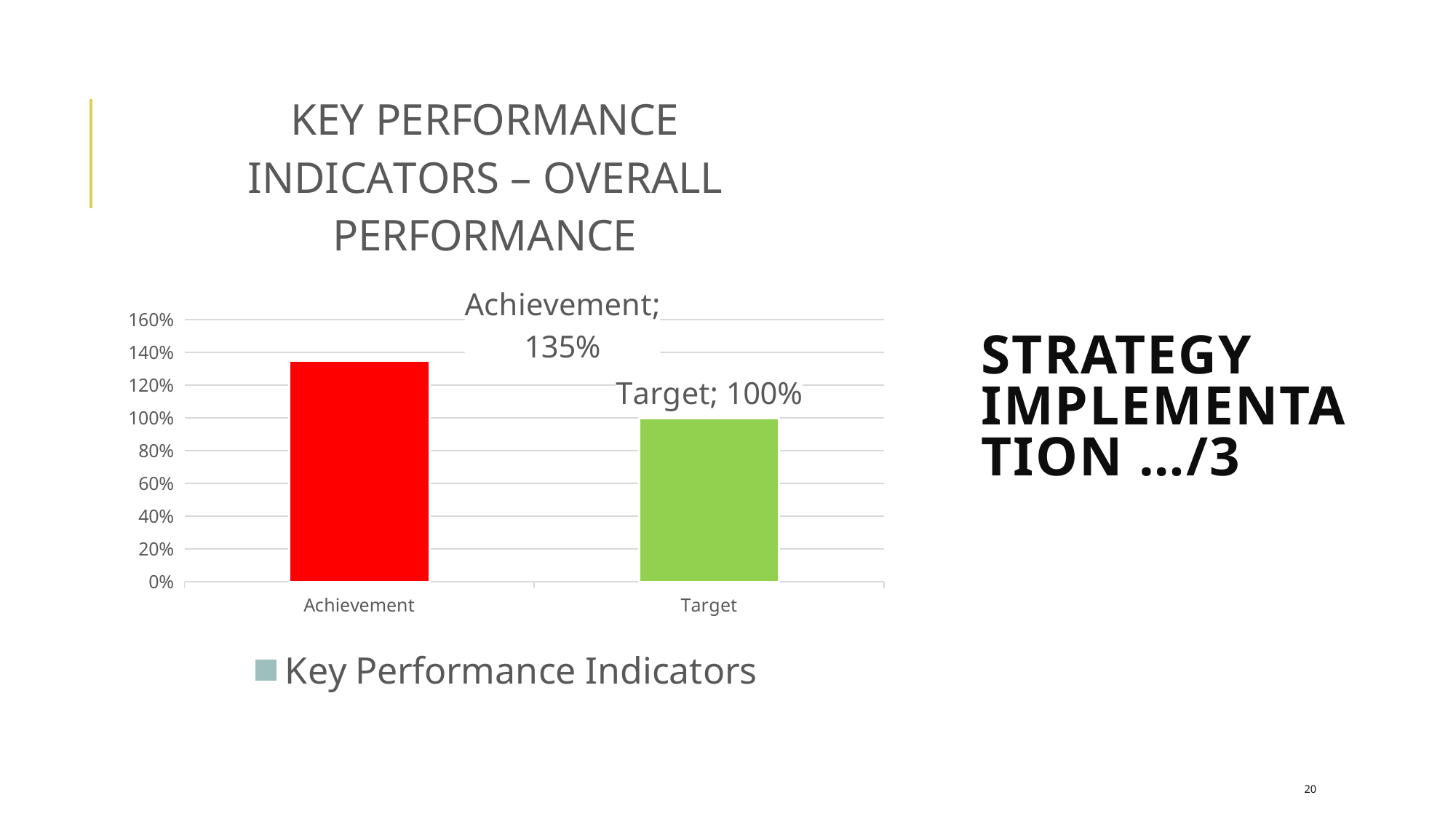
Which category has the lowest value? Target What is the value for Achievement? 135% Is the value for Achievement greater or less than 120%? greater How many categories are shown on the x axis? 2 What is the difference between the Achievement value and the Target value? 35% Is the value for Target greater or less than 120%? less How many series does the legend list? 1 What kind of chart is shown on the slide? Bar chart What is the value for Target? 100% What is the title of the chart? Key Performance Indicators – Overall Performance Which category has the highest value? Achievement Which is larger, the value for Achievement or the value for Target? Achievement